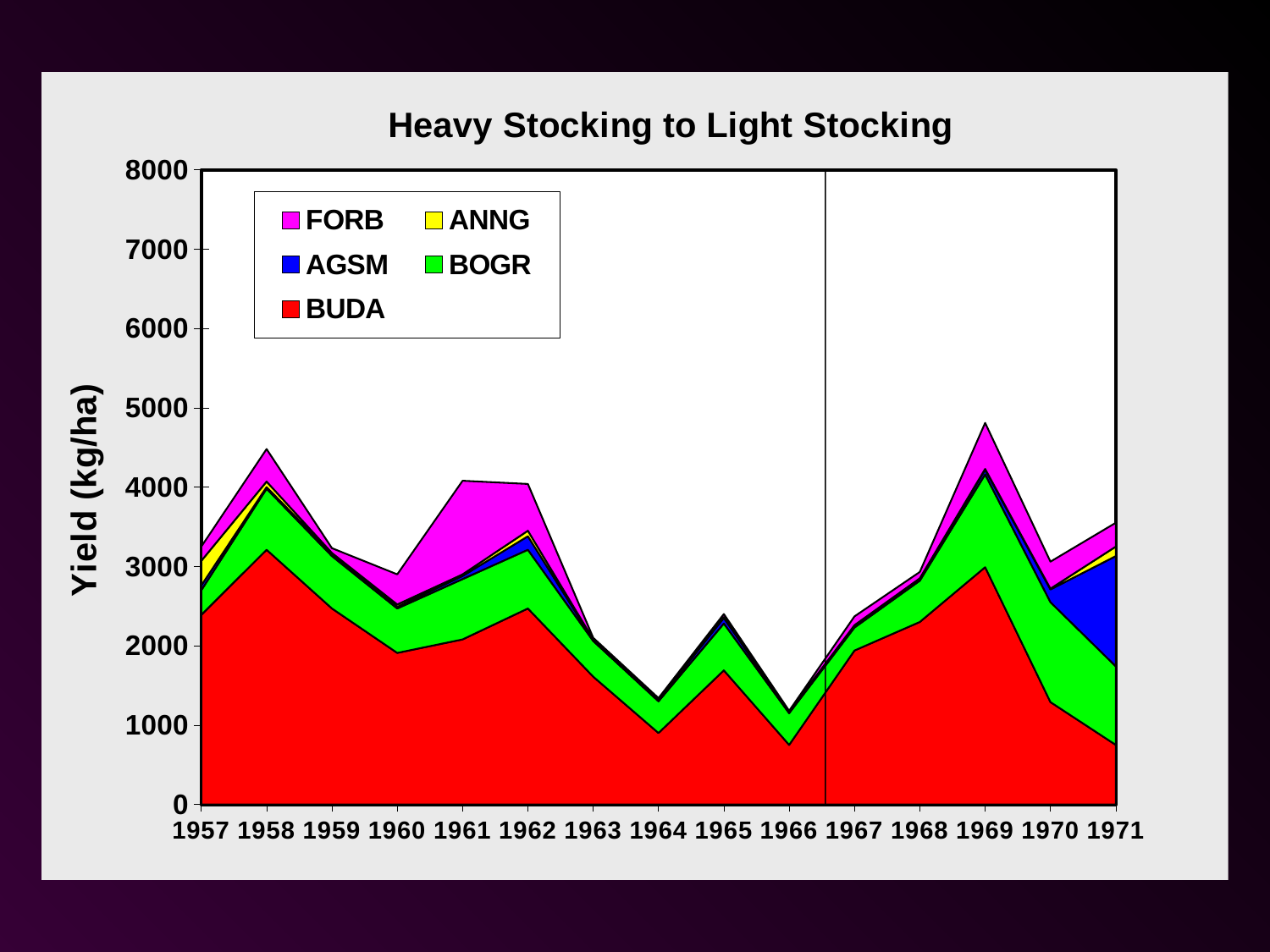
Does the total stacked yield rise or fall from 1962 to 1964? fall Which year has the larger total stacked yield, 1961 or 1963? 1961 Is the BUDA value for 1966 greater or less than 1000? less What is the title of the chart? Heavy Stocking to Light Stocking In which year is the total stacked yield highest? 1969 In which year is the total stacked yield lowest? 1966 Is the BUDA value for 1958 greater or less than 3000? greater What kind of chart is shown on the slide? Stacked area chart What is the label on the y axis? Yield (kg/ha) How many years are shown along the x axis? 15 How many series does the legend list? 5 Is the total stacked yield for 1969 greater or less than 4000? greater